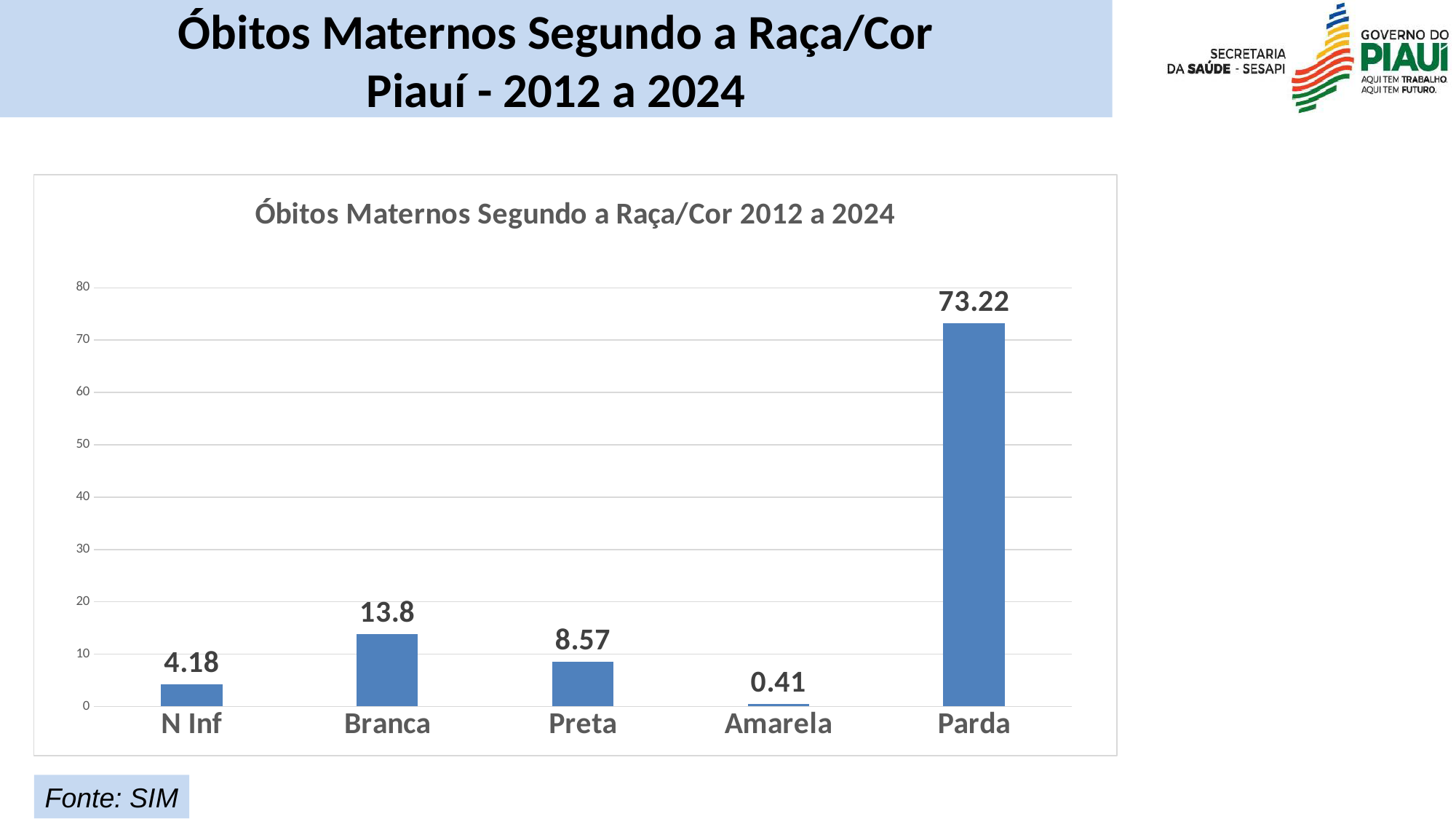
What is the difference between the values for Branca and Preta? 5.23 Is the value for Parda greater or less than 70? greater Which category has the lowest value? Amarela Which category has the highest value? Parda What is the value for N Inf? 4.18 What is the value for Parda? 73.22 What kind of chart is shown on the slide? bar chart What is the value for Branca? 13.8 How many categories are shown on the x axis? 5 Which is larger, the value for Preta or the value for N Inf? Preta What is the value for Amarela? 0.41 What is the title of the chart? Óbitos Maternos Segundo a Raça/Cor 2012 a 2024